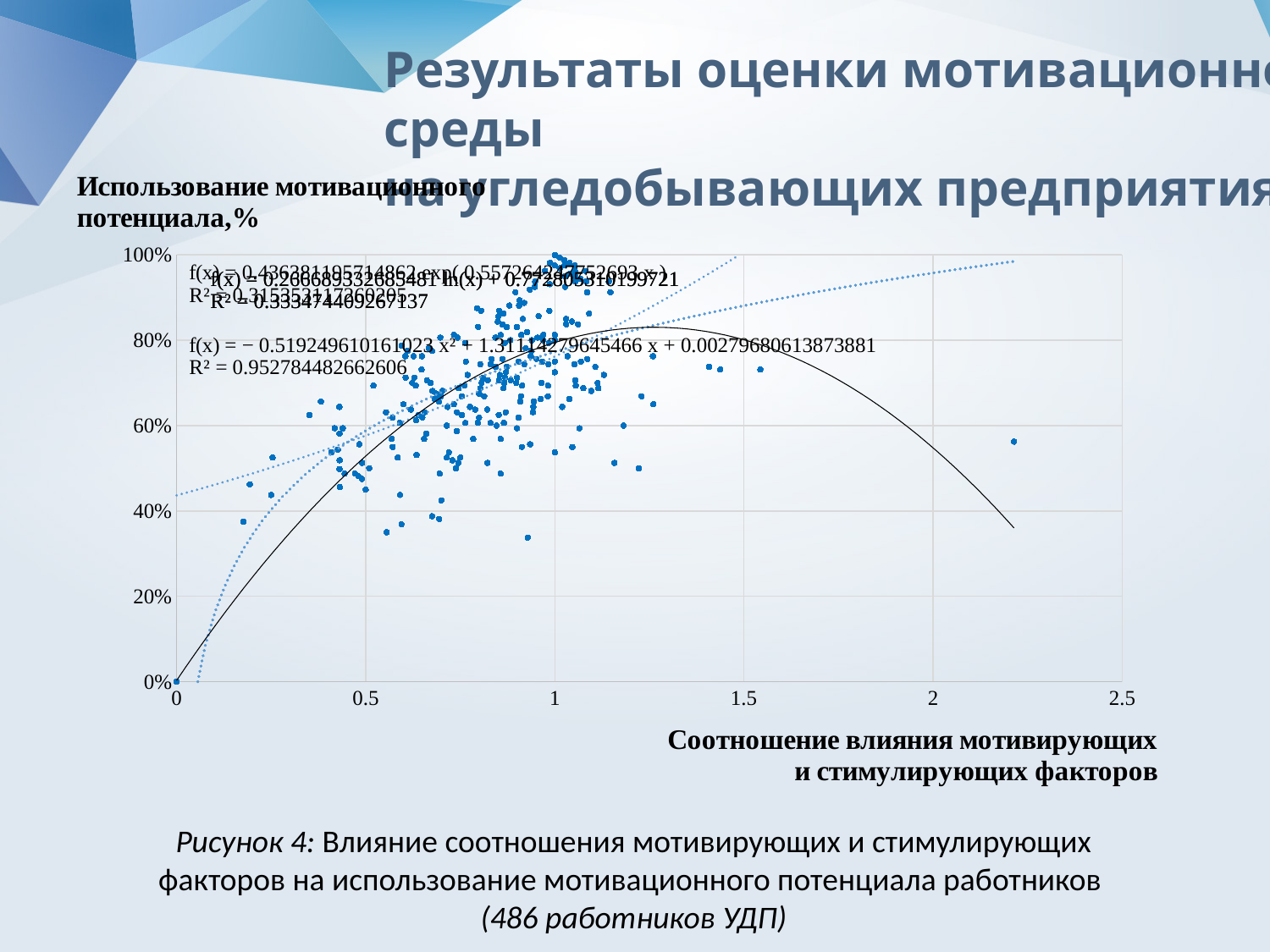
What kind of chart is shown on the slide? scatter chart What is the highest tick value shown on the horizontal axis? 2.5 Is the value of the isolated data point near x = 2.2 greater or less than 60%? less Is the value of the isolated data point near x = 2.2 greater or less than 40%? greater What R² value is shown for the quadratic (x²) trendline on the chart? 0.952784482662606 Does the solid fitted curve rise or fall as x increases from 1.5 to 2.2? fall What is the highest tick value shown on the vertical axis? 100% What is the label of the horizontal axis of the chart? Соотношение влияния мотивирующих и стимулирующих факторов Is the value of the lowest data point near x = 1 greater or less than 40%? less How many fitted trendlines are drawn on the chart? 3 Does the solid fitted curve rise or fall as x increases from 0 to 1? rise